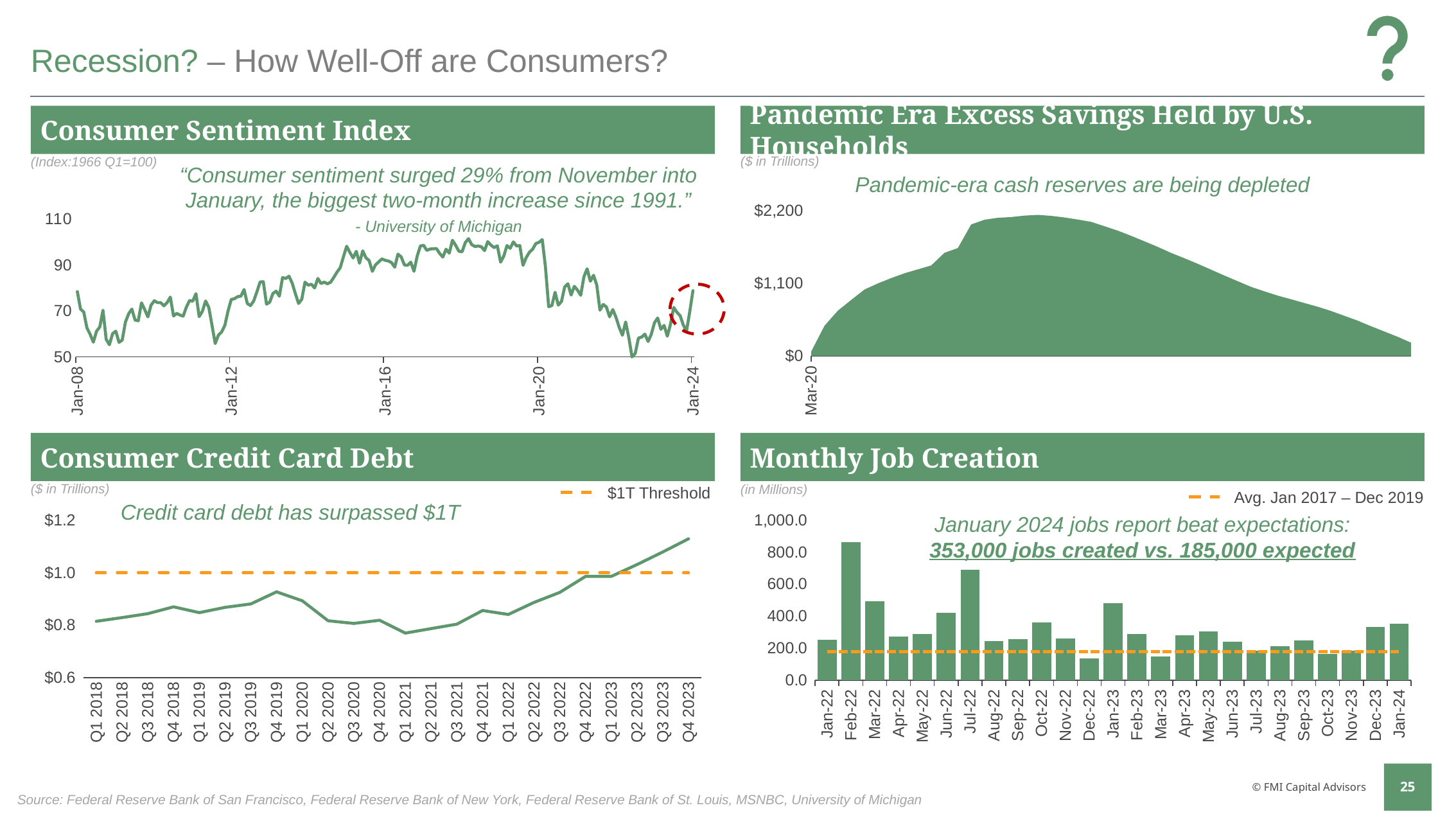
What does the dashed line in the Monthly Job Creation chart represent, according to the legend? Avg. Jan 2017 – Dec 2019 What kind of chart is the Monthly Job Creation chart? bar chart In the Pandemic Era Excess Savings chart, do values rise or fall over the right half of the chart? fall In the Monthly Job Creation chart, which is larger, the bar for Jan-23 or the bar for Dec-22? Jan-23 In the Monthly Job Creation chart, which month has the highest bar? Feb-22 What kind of chart is the Consumer Credit Card Debt chart? line chart How many monthly bars are plotted in the Monthly Job Creation chart? 25 In the Consumer Credit Card Debt chart, is the value for Q4 2023 greater or less than $1.0? greater In the Monthly Job Creation chart, is the value for Feb-22 greater or less than 800.0? greater In the Consumer Credit Card Debt chart, which quarter has the lowest value? Q1 2021 In the Consumer Credit Card Debt chart, do values rise or fall from Q1 2021 to Q4 2023? rise In the Monthly Job Creation chart, is the value for Jul-22 greater or less than 600.0? greater